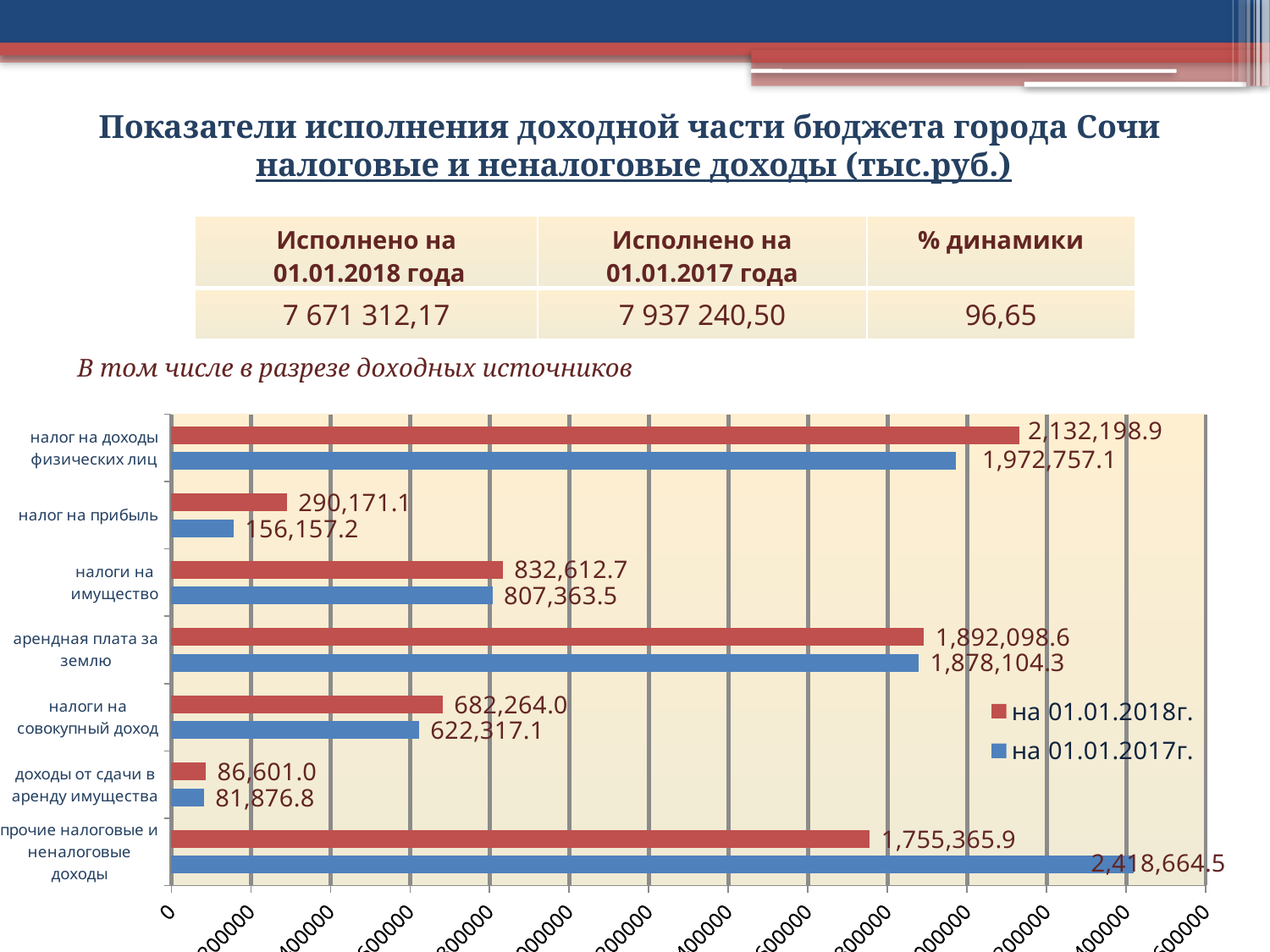
What is the value for 'налог на прибыль' in the 'на 01.01.2017г.' series? 156,157.2 What is the value for 'прочие налоговые и неналоговые доходы' in the 'на 01.01.2017г.' series? 2,418,664.5 How many series does the chart legend list? 2 Is the 'на 01.01.2018г.' value for 'арендная плата за землю' greater or less than 1800000? greater What is the difference between the 'на 01.01.2018г.' and 'на 01.01.2017г.' values for 'налог на прибыль'? 134,013.9 Which category has the lowest value in the 'на 01.01.2017г.' series? доходы от сдачи в аренду имущества Which colour represents the 'на 01.01.2017г.' series in the chart? blue Which category has the highest value in the 'на 01.01.2018г.' series? налог на доходы физических лиц For 'прочие налоговые и неналоговые доходы', which series has the larger value: 'на 01.01.2018г.' or 'на 01.01.2017г.'? на 01.01.2017г. What type of chart is shown on the slide? bar chart How many categories are shown on the chart? 7 What is the value for 'налог на доходы физических лиц' in the 'на 01.01.2018г.' series? 2,132,198.9